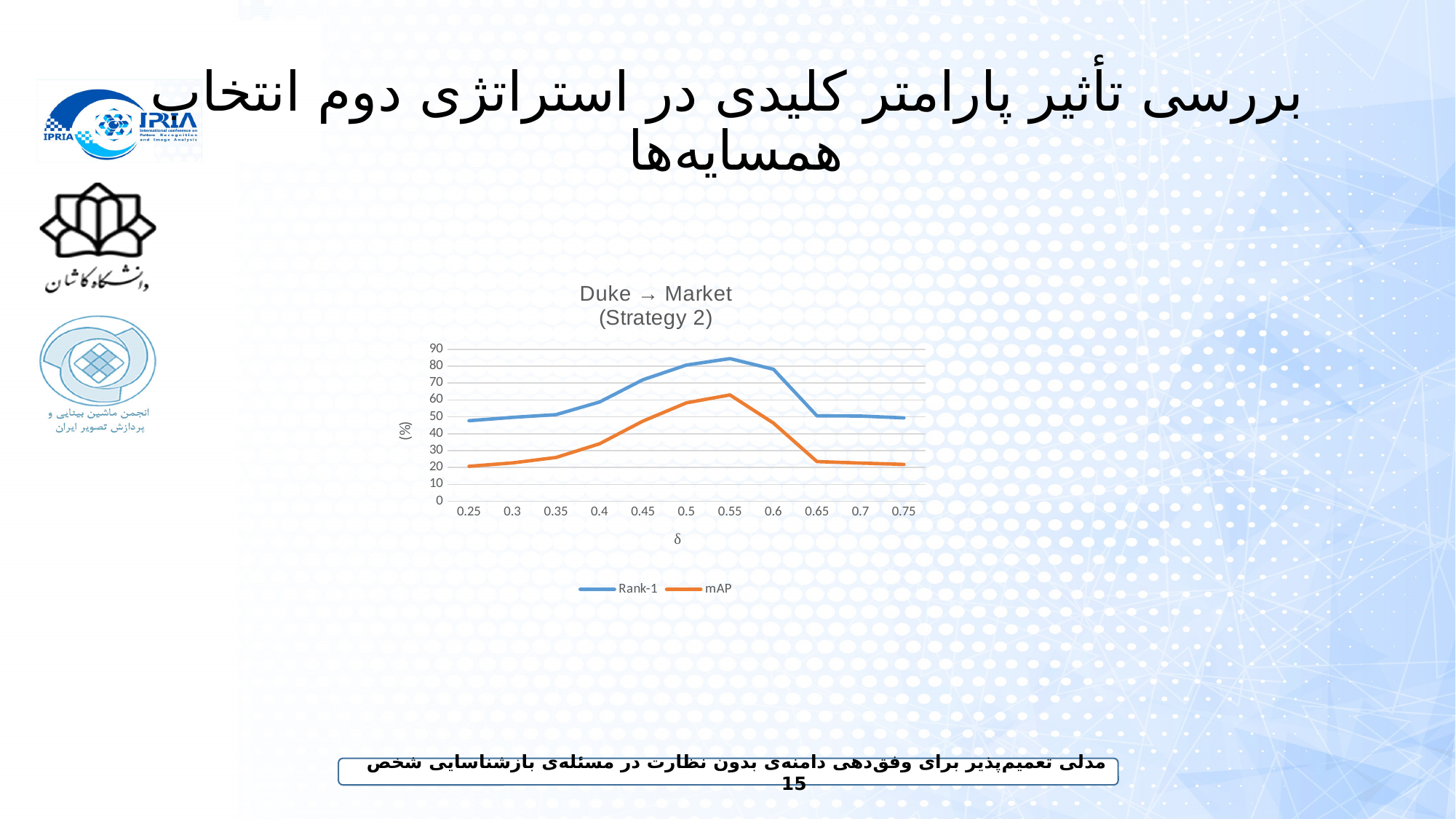
Is the Rank-1 value at δ = 0.25 greater or less than 60? less Is the Rank-1 value at δ = 0.55 greater or less than 80? greater Is the mAP value at δ = 0.25 greater or less than 30? less At which δ value does the mAP series reach its highest point? 0.55 How many δ values are plotted along the x axis? 11 How many series does the legend list? 2 What are the two series named in the legend? Rank-1 and mAP What is the title of the chart? Duke → Market (Strategy 2) At δ = 0.5, which series has the larger value, Rank-1 or mAP? Rank-1 Does the Rank-1 series rise or fall between δ = 0.55 and δ = 0.65? fall What kind of chart is shown on the slide? line chart At which δ value does the Rank-1 series reach its highest point? 0.55